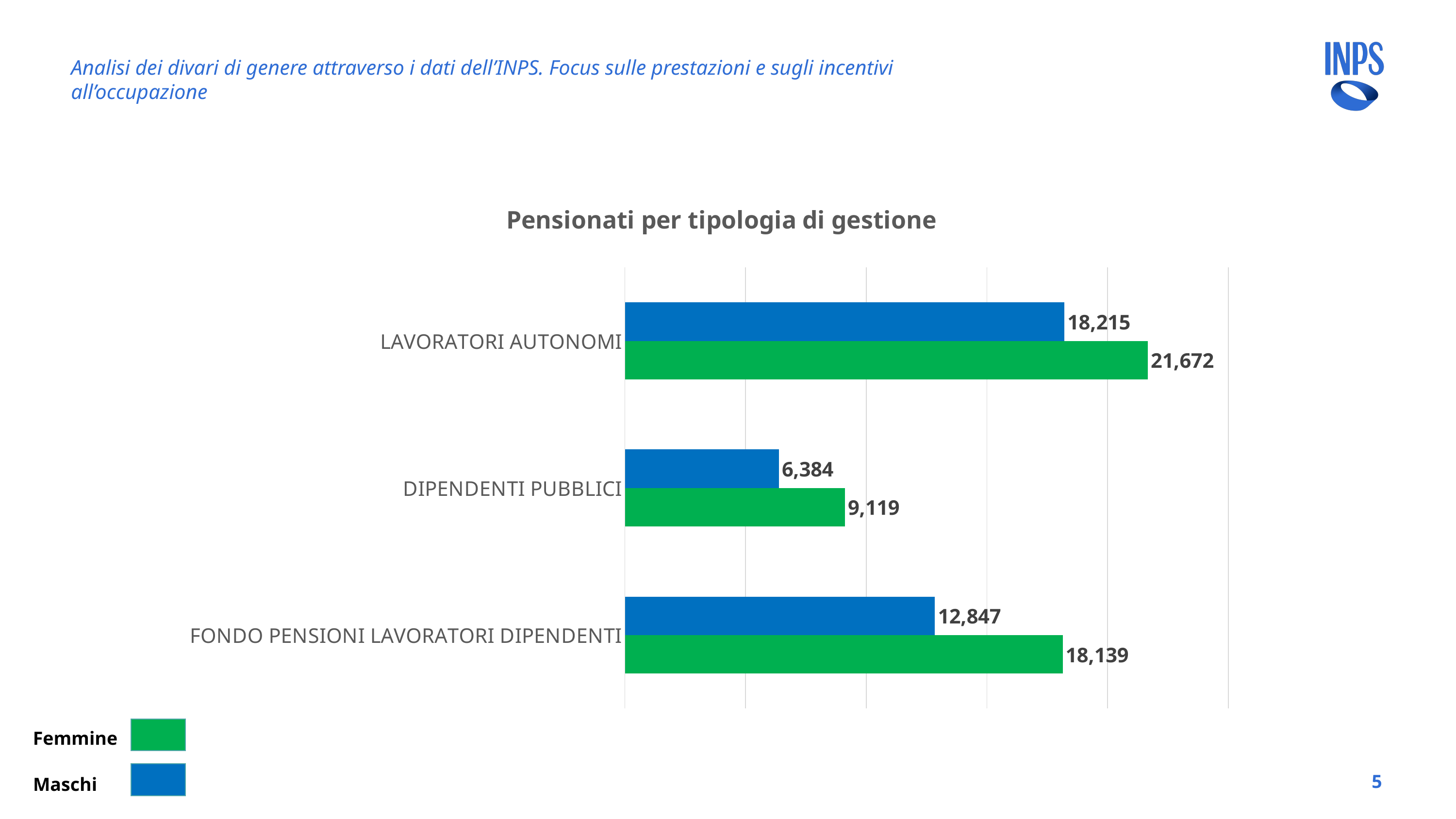
Which category has the lowest Maschi value? DIPENDENTI PUBBLICI What is the Maschi value for LAVORATORI AUTONOMI? 18,215 What is the Maschi value for DIPENDENTI PUBBLICI? 6,384 What kind of chart is shown on the slide? Bar chart What is the Femmine value for FONDO PENSIONI LAVORATORI DIPENDENTI? 18,139 What is the difference between the Femmine and Maschi values for DIPENDENTI PUBBLICI? 2,735 What is the Femmine value for LAVORATORI AUTONOMI? 21,672 Which is larger for LAVORATORI AUTONOMI, the Femmine value or the Maschi value? Femmine How many categories are shown on the chart? 3 How many series does the legend list? 2 Which category has the highest Femmine value? LAVORATORI AUTONOMI What is the difference between the Femmine and Maschi values for FONDO PENSIONI LAVORATORI DIPENDENTI? 5,292